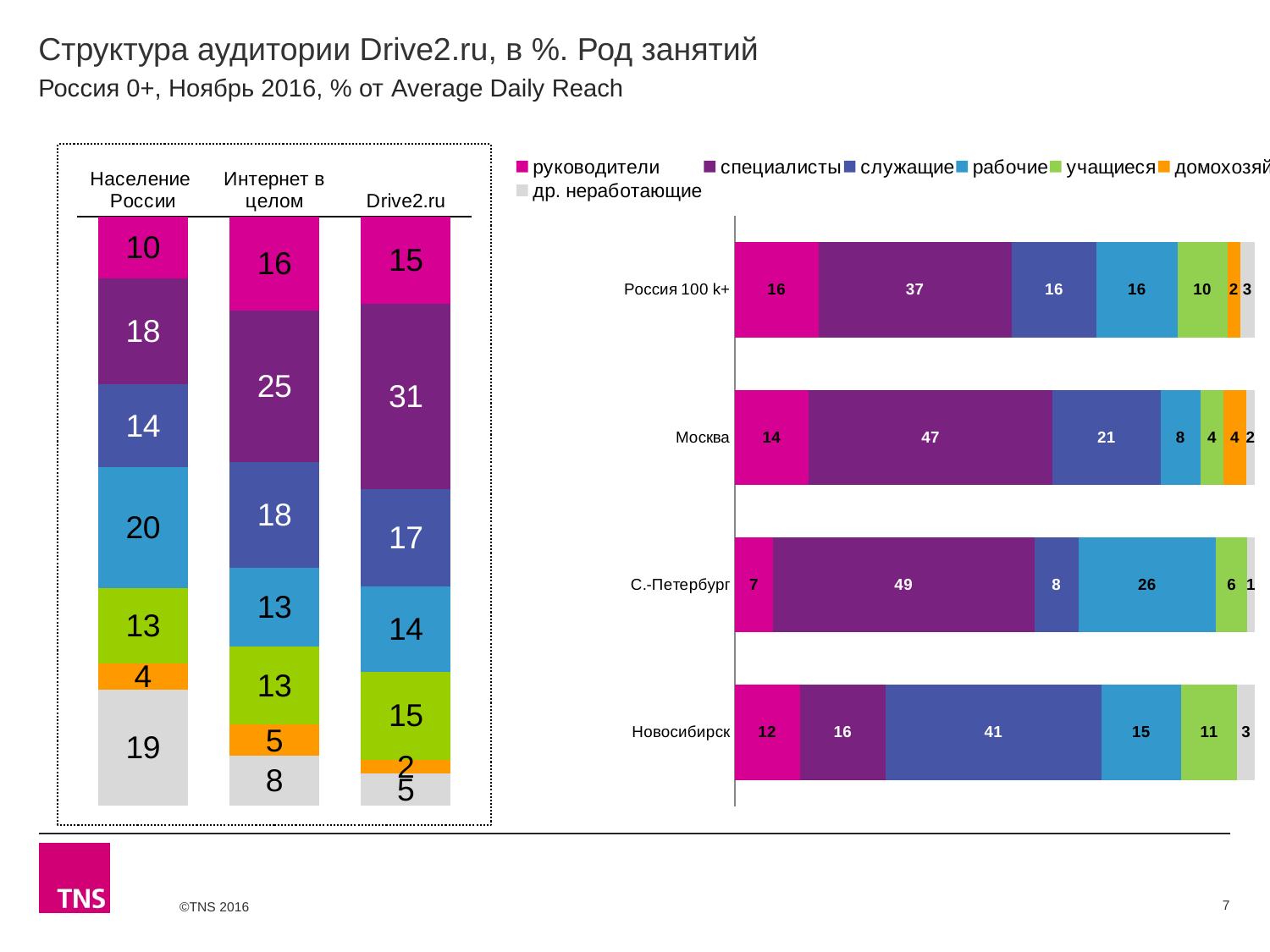
In the left chart, what is the value of the руководители segment for Население России? 10 What type of chart is the right chart? Stacked bar chart In the right chart, what is the value of the учащиеся segment for Новосибирск? 11 In the right chart, what is the value of the рабочие segment for С.-Петербург? 26 How many cities/regions are shown in the right chart? 4 In the left chart, what is the value of the специалисты segment for Drive2.ru? 31 In the left chart, what is the difference between the специалисты values for Drive2.ru and Население России? 13 In the right chart, which is larger: the руководители value for Россия 100 k+ or for С.-Петербург? Россия 100 k+ In the right chart, which city has the largest служащие segment? Новосибирск In the left chart, which column has the smallest др. неработающие segment? Drive2.ru In the right chart, what is the value of the специалисты segment for Москва? 47 How many columns (categories) are shown in the left chart? 3